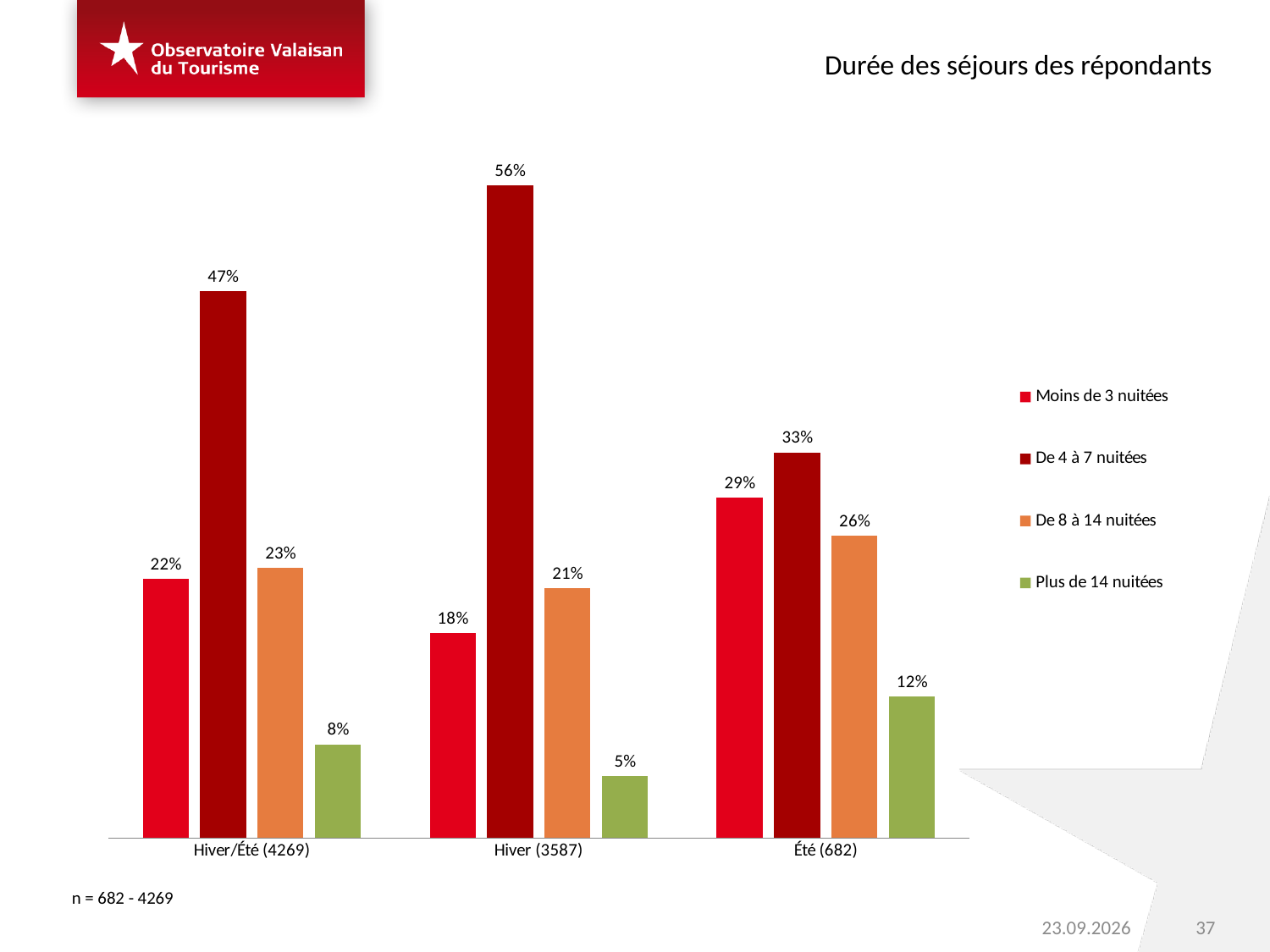
What kind of chart is shown on the slide? Bar chart How many categories are shown on the x axis? 3 How many series does the legend list? 4 What is the value for 'Moins de 3 nuitées' in the 'Hiver/Été (4269)' category? 22% Which series has the lowest value in the 'Hiver (3587)' category? Plus de 14 nuitées Which is larger: 'Moins de 3 nuitées' in 'Été (682)' or 'De 8 à 14 nuitées' in 'Été (682)'? Moins de 3 nuitées Which series has the highest value in the 'Été (682)' category? De 4 à 7 nuitées What is the difference between 'De 4 à 7 nuitées' in 'Hiver (3587)' and in 'Été (682)'? 23% What is the title of the chart? Durée des séjours des répondants What colour are the bars for 'Plus de 14 nuitées'? Green What is the value for 'De 4 à 7 nuitées' in the 'Hiver (3587)' category? 56% What is the value for 'Plus de 14 nuitées' in the 'Été (682)' category? 12%